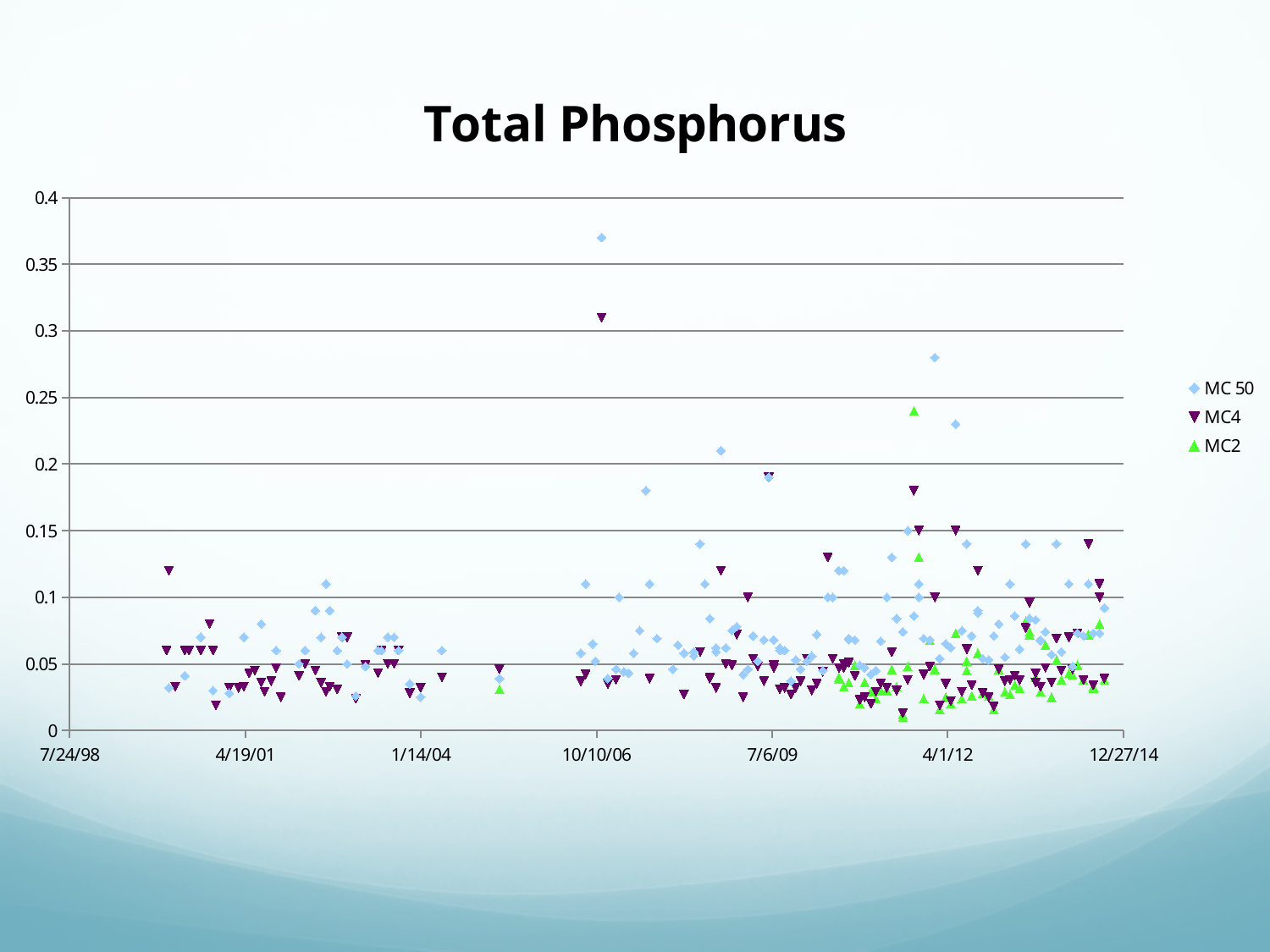
How many series does the legend list? 3 Is the highest MC2 value greater or less than 0.25? less What is the maximum value shown on the vertical axis? 0.4 Is the highest MC2 value greater or less than 0.2? greater Is the highest MC 50 value greater or less than 0.35? greater What kind of chart is shown on the slide? scatter chart Is the highest MC 50 value larger than the highest MC4 value? yes Which series has the lowest maximum value on the chart? MC2 What is the title of the chart? Total Phosphorus Which series has the highest single point on the chart? MC 50 How many date labels are shown along the horizontal axis? 7